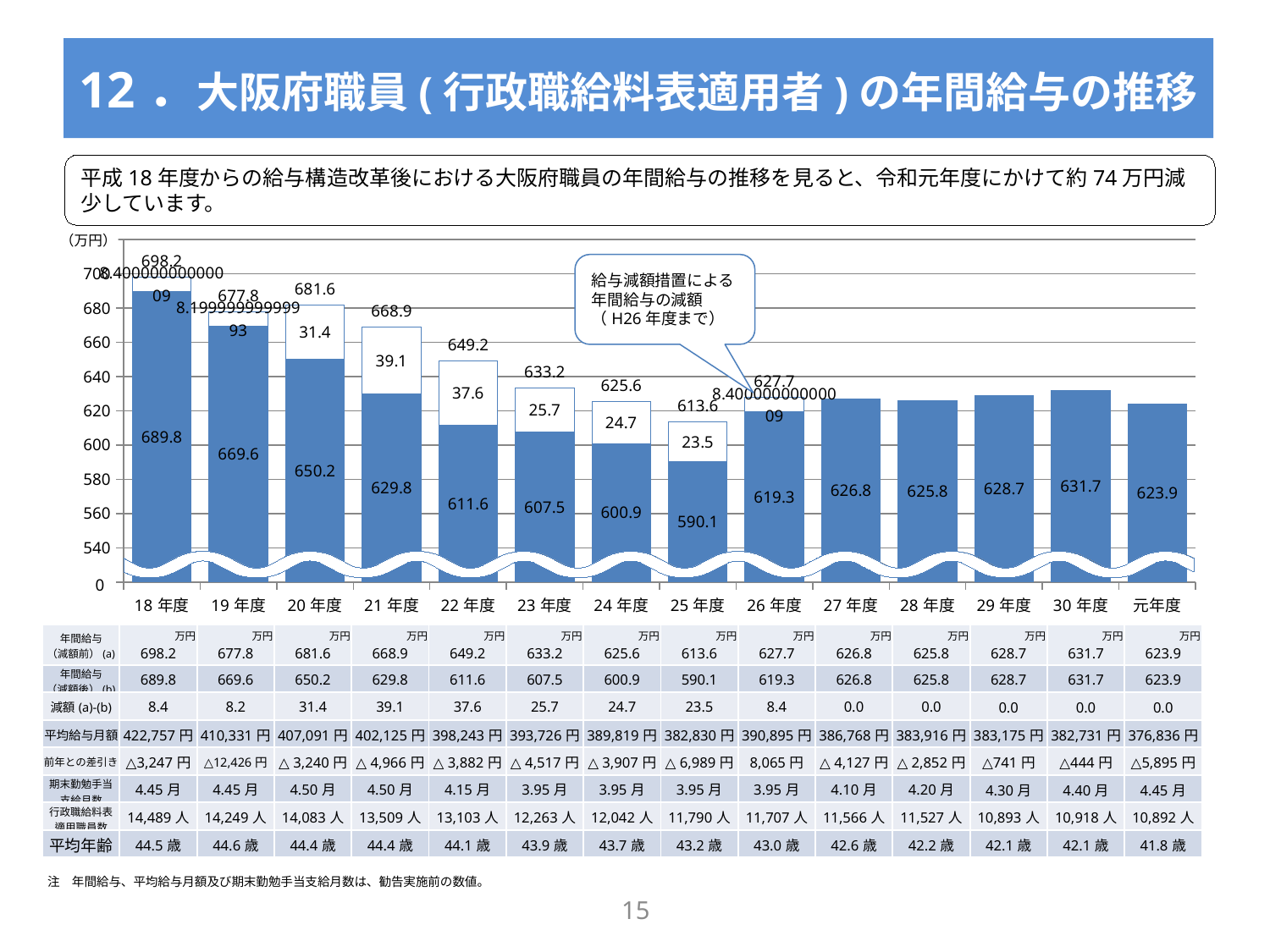
Is the blue bar value for 24年度 greater or less than 620? less What is the value of the blue (減額後) bar segment for 18年度? 689.8 What kind of chart is shown on the slide? bar chart Which fiscal year has the lowest blue (減額後) bar value? 25年度 How many fiscal-year categories are plotted along the x axis of the chart? 14 Which fiscal year has the highest total (減額前) annual salary? 18年度 What unit is shown at the top of the y axis? 万円 What is the difference between the blue bar values for 18年度 (689.8) and 25年度 (590.1)? 99.7 What is the value of the white (減額) segment for 21年度? 39.1 What is the value of the blue bar segment for 元年度? 623.9 Which is larger, the blue bar value for 27年度 or for 28年度? 27年度 What is the total annual salary (減額前) shown above the bar for 22年度? 649.2